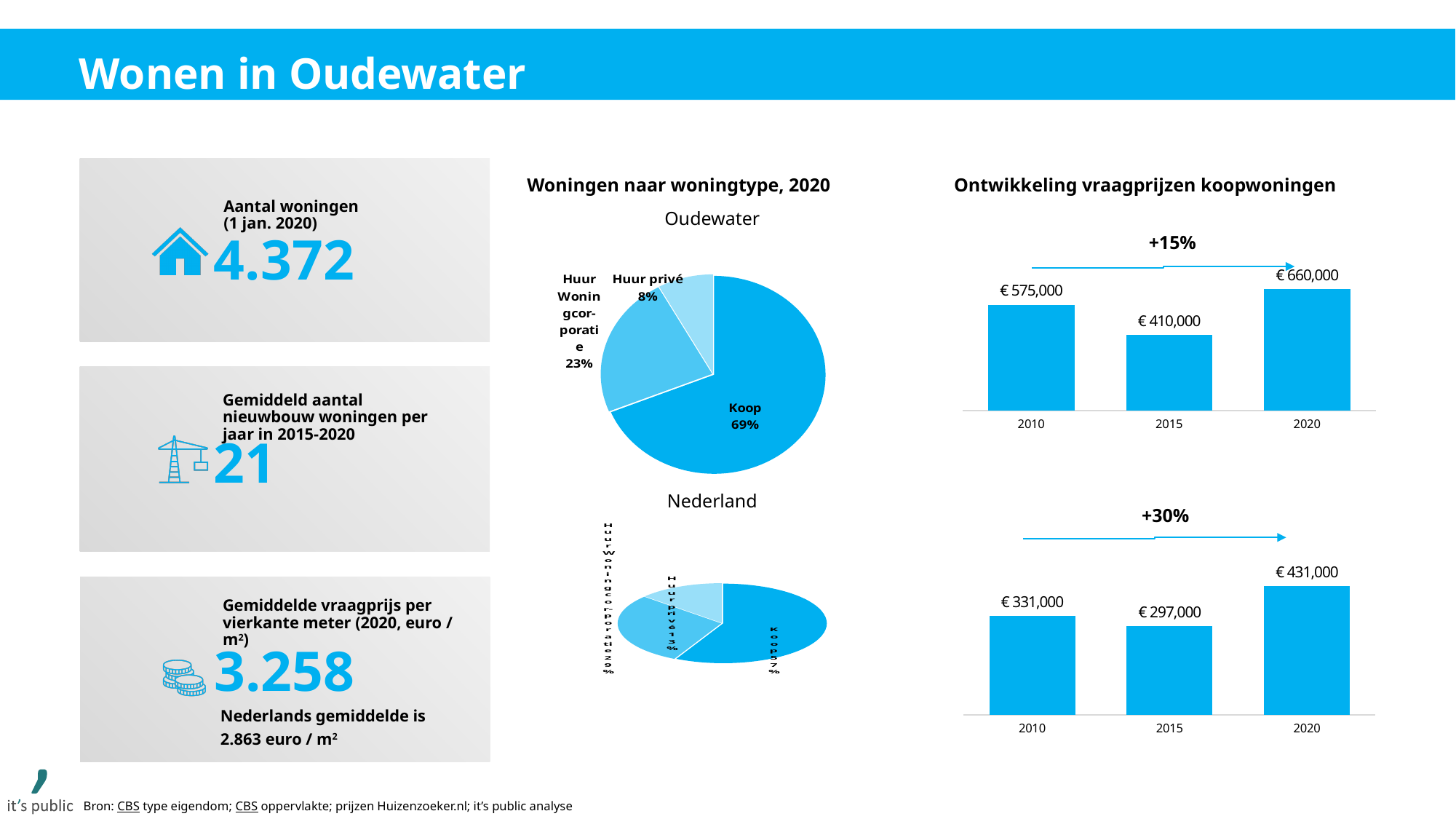
What type of chart is used for 'Ontwikkeling vraagprijzen koopwoningen'? bar chart In the Oudewater pie chart, what share is Huur privé? 8% In the upper bar chart under 'Ontwikkeling vraagprijzen koopwoningen', what is the value for 2010? € 575,000 In the upper bar chart under 'Ontwikkeling vraagprijzen koopwoningen', which year has the lowest value? 2015 In the Oudewater pie chart, what share is Huur Woningcorporatie? 23% In the Oudewater pie chart, what share is Koop? 69% In the Oudewater pie chart, which category has the smallest slice? Huur privé In the lower bar chart under 'Ontwikkeling vraagprijzen koopwoningen', what is the value for 2020? € 431,000 How many slices does the Oudewater pie chart have? 3 In the Oudewater pie chart, which category has the largest slice? Koop In the lower bar chart under 'Ontwikkeling vraagprijzen koopwoningen', is the value for 2010 larger or smaller than the value for 2015? larger In the upper bar chart under 'Ontwikkeling vraagprijzen koopwoningen', what is the difference between the 2020 and 2010 values? € 85,000